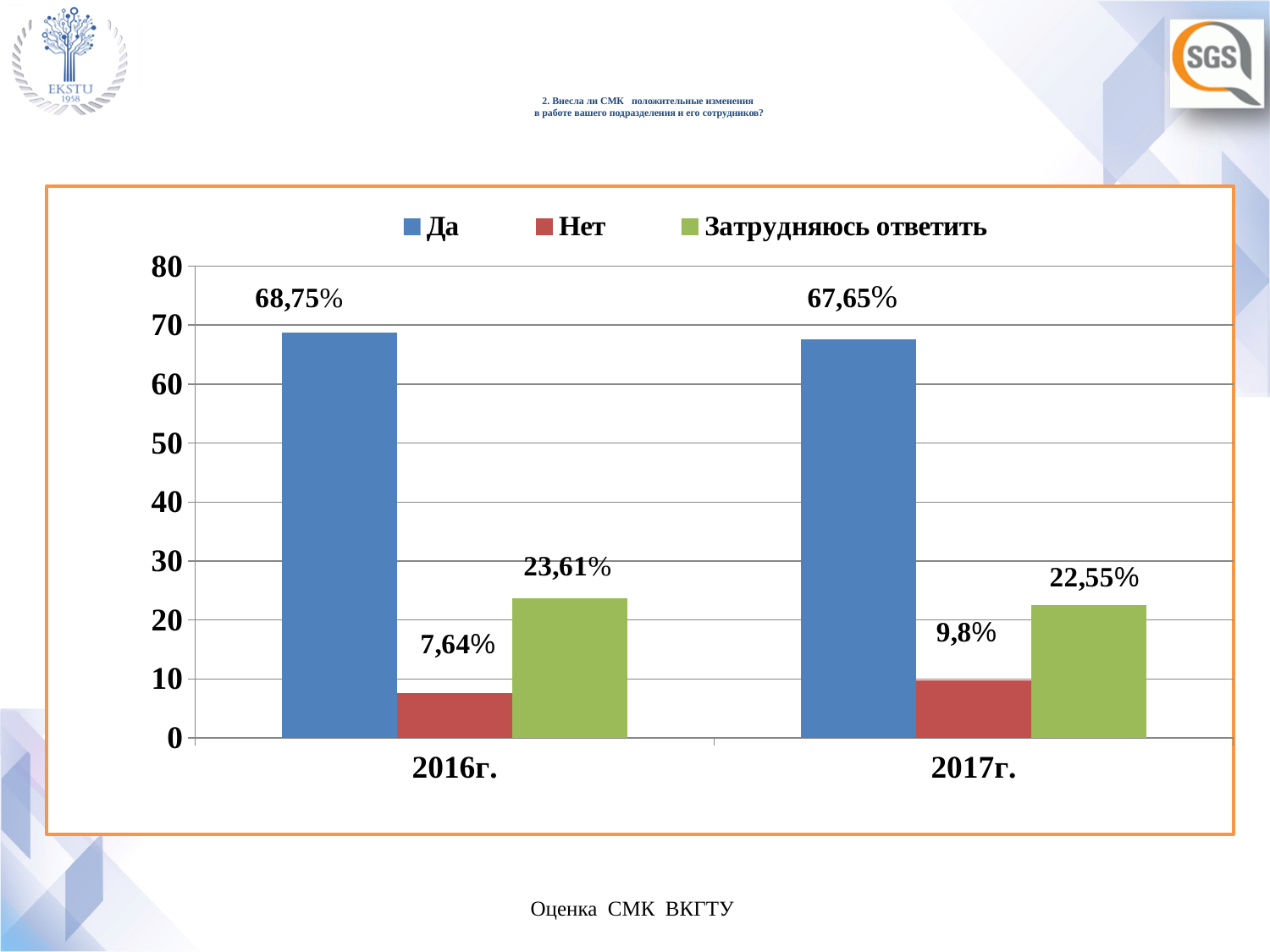
What is the value for "Нет" in 2017г.? 9,8% Which is larger: "Нет" in 2016г. or "Нет" in 2017г.? Нет in 2017г. Is the value for "Затрудняюсь ответить" in 2017г. greater or less than 30? less What kind of chart is shown on the slide? bar chart What is the value for "Да" in 2017г.? 67,65% Which series has the lowest value in 2016г.? Нет Does the value for "Да" rise or fall from 2016г. to 2017г.? fall Which series has the highest value in 2017г.? Да What is the value for "Затрудняюсь ответить" in 2016г.? 23,61% What is the value for "Да" in 2016г.? 68,75% What is the difference between the "Да" values for 2016г. and 2017г.? 1,1% How many series does the legend list? 3